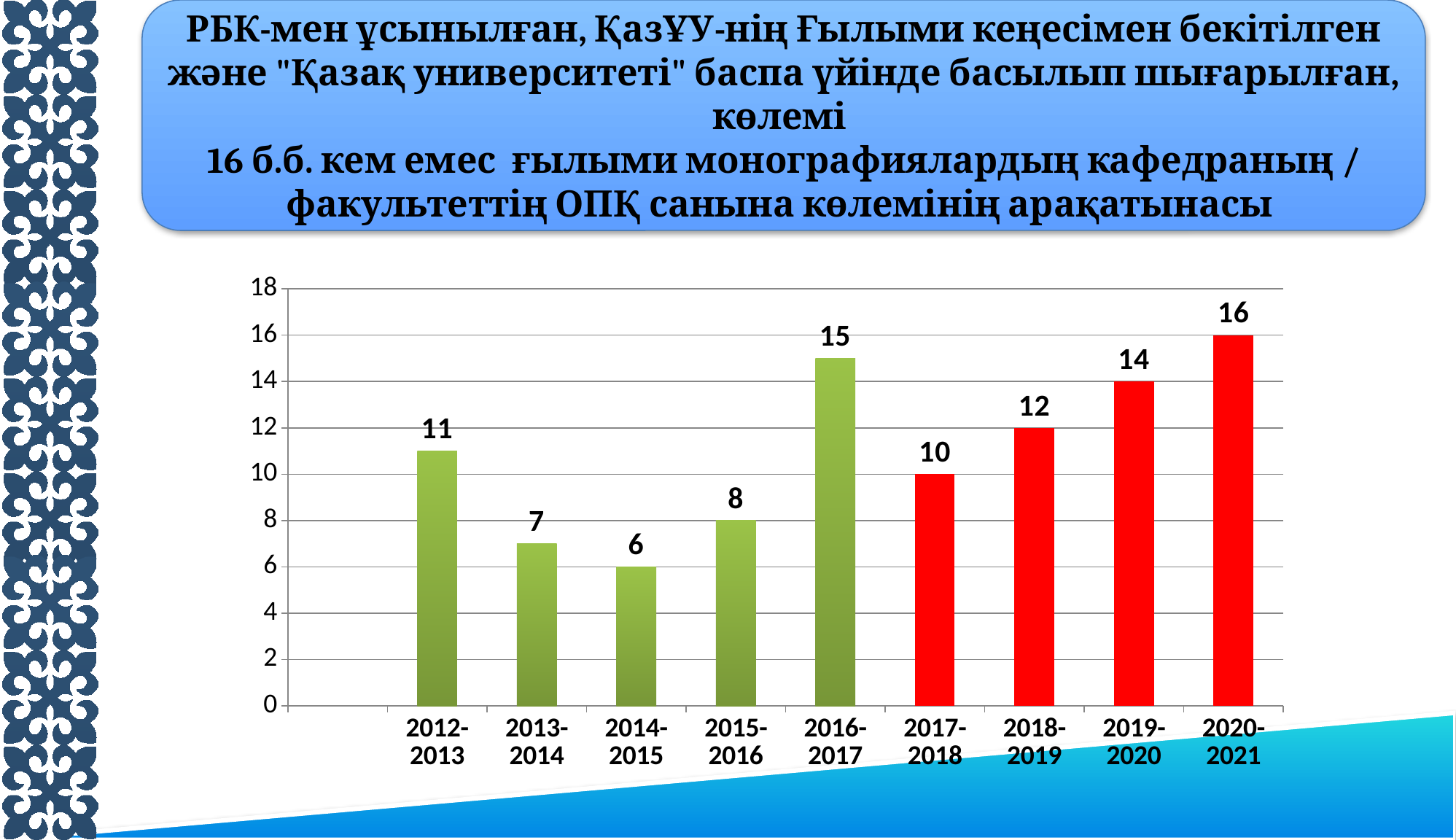
What is the difference between the values for 2016-2017 and 2017-2018? 5 Do the values rise or fall from 2017-2018 to 2020-2021? rise Which academic year has the highest value? 2020-2021 What is the difference between the values for 2020-2021 and 2012-2013? 5 What colour are the bars for 2017-2018 through 2020-2021? red How many academic years are shown on the x axis? 9 What kind of chart is shown on the slide? bar chart Which academic year has the lowest value? 2014-2015 What is the value for 2016-2017? 15 What is the value for 2012-2013? 11 What is the value for 2019-2020? 14 Which is larger, the value for 2015-2016 or the value for 2018-2019? 2018-2019